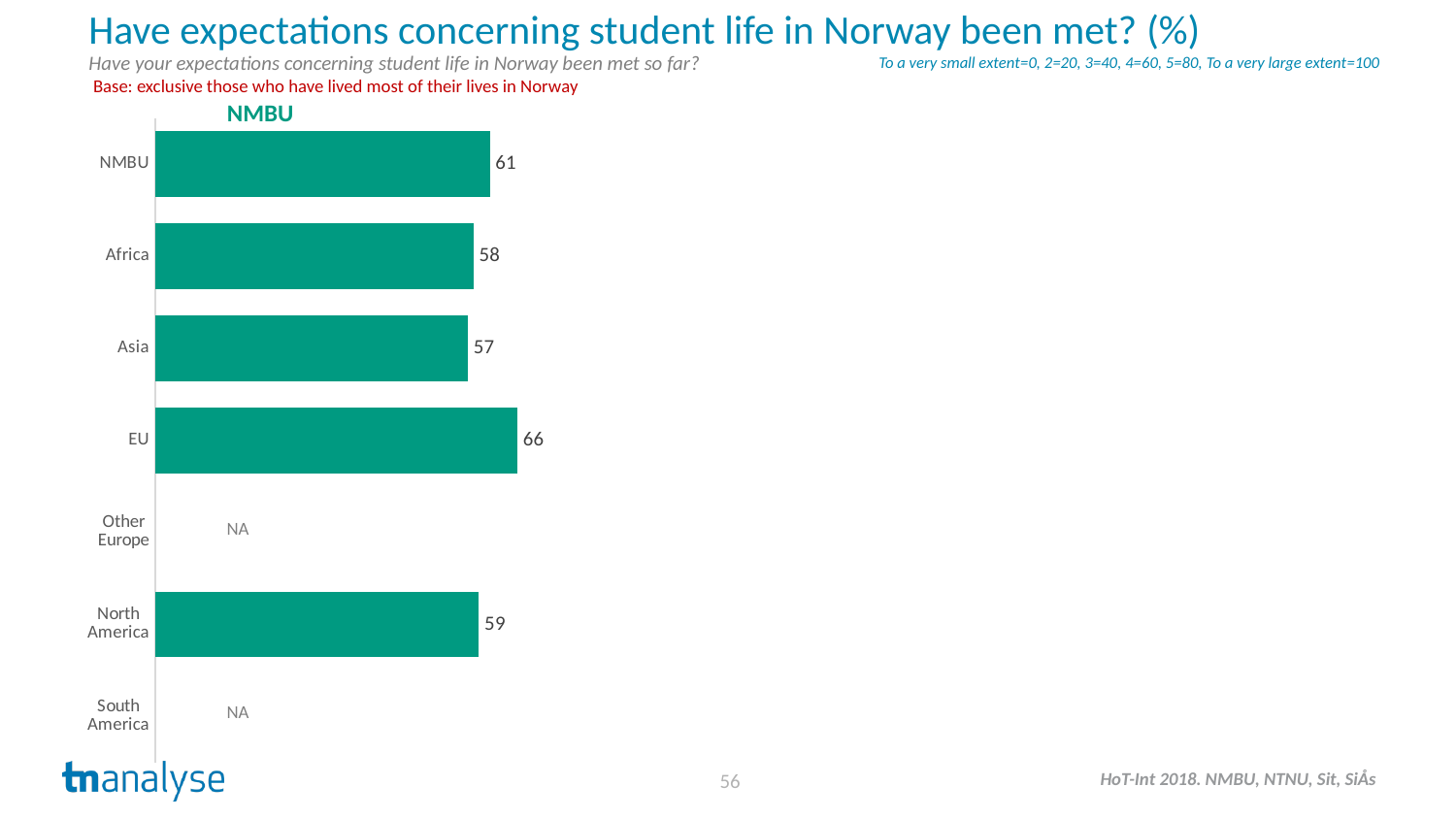
What is the value for Africa? 58 What is the label shown above the chart? NMBU Which category with a plotted value has the lowest value? Asia Which is larger, the value for NMBU or the value for Africa? NMBU What is shown for Other Europe? NA What is the value for North America? 59 What is the difference between the values for EU and Asia? 9 Which category has the highest value? EU How many categories are listed on the chart's axis? 7 What is the value for EU? 66 How many categories show NA instead of a bar? 2 What kind of chart is shown? bar chart